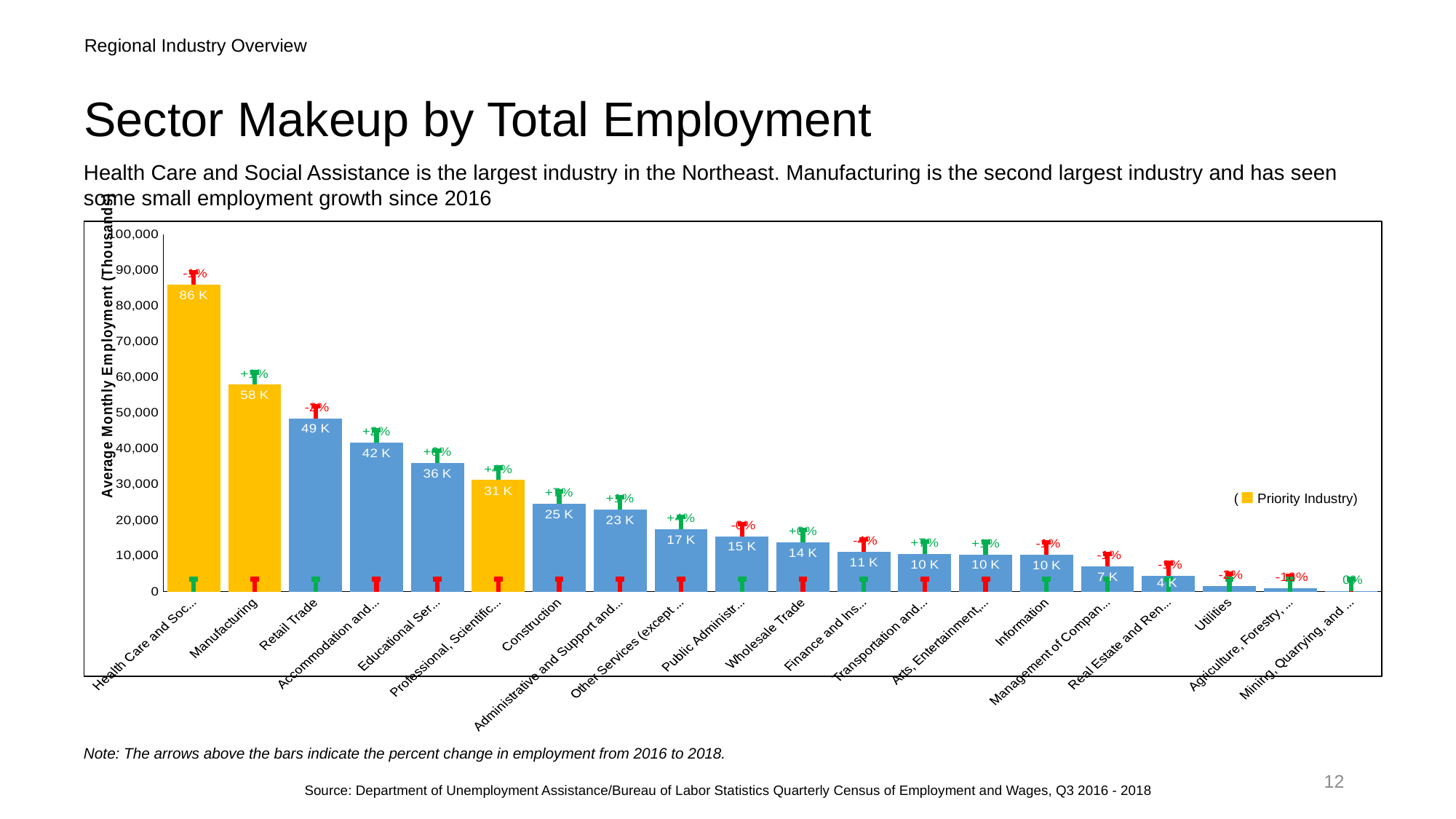
How many industry bars are shown in the chart? 20 Is the value for Utilities greater or less than 10,000? less What is the value labelled on the Construction bar? 25 K Do the bar values rise or fall from left to right along the x axis? fall What is the average monthly employment value shown for Manufacturing? 58 K What is the difference between the Manufacturing and Retail Trade values? 9 K Which is larger, the value for Construction or the value for Wholesale Trade? Construction Which industry has the highest average monthly employment? Health Care and Social Assistance What is the value labelled on the Retail Trade bar? 49 K What kind of chart is shown on the slide? bar chart What is the value labelled on the Wholesale Trade bar? 14 K Which industry has the lowest average monthly employment? Mining, Quarrying, and ...